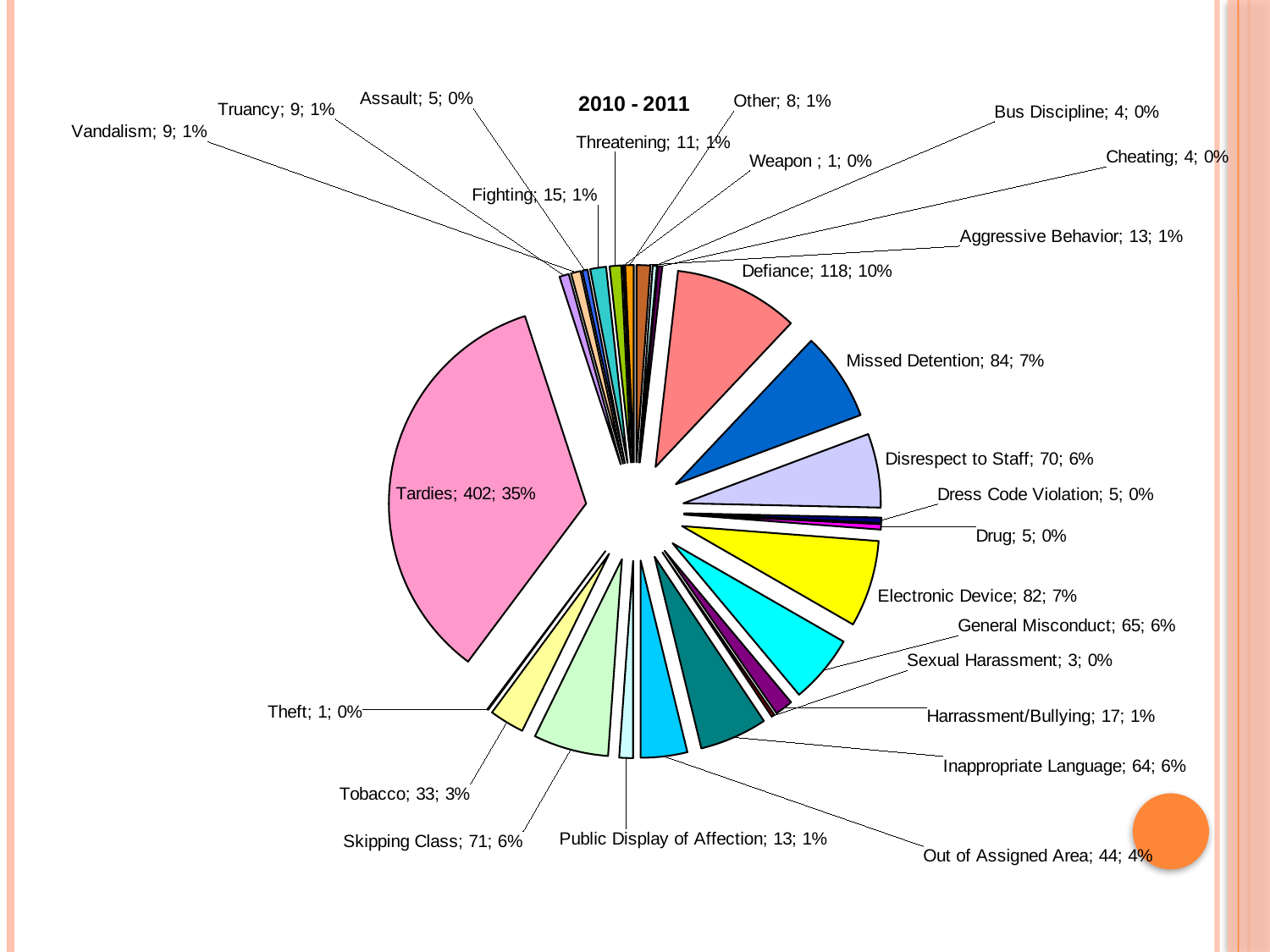
Which is larger, Electronic Device or Disrespect to Staff? Electronic Device What is the title of the chart? 2010 - 2011 What is the value for Tardies? 402 What is the difference between the values for Skipping Class and Inappropriate Language? 7 What share of the pie does Defiance represent? 10% What kind of chart is shown on the slide? Pie chart What is the difference between the values for Defiance and Missed Detention? 34 What share of the pie does Tobacco represent? 3% What is the value for Missed Detention? 84 Which category has the largest slice of the pie? Tardies How many categories are shown in the pie chart? 26 What is the value for Out of Assigned Area? 44